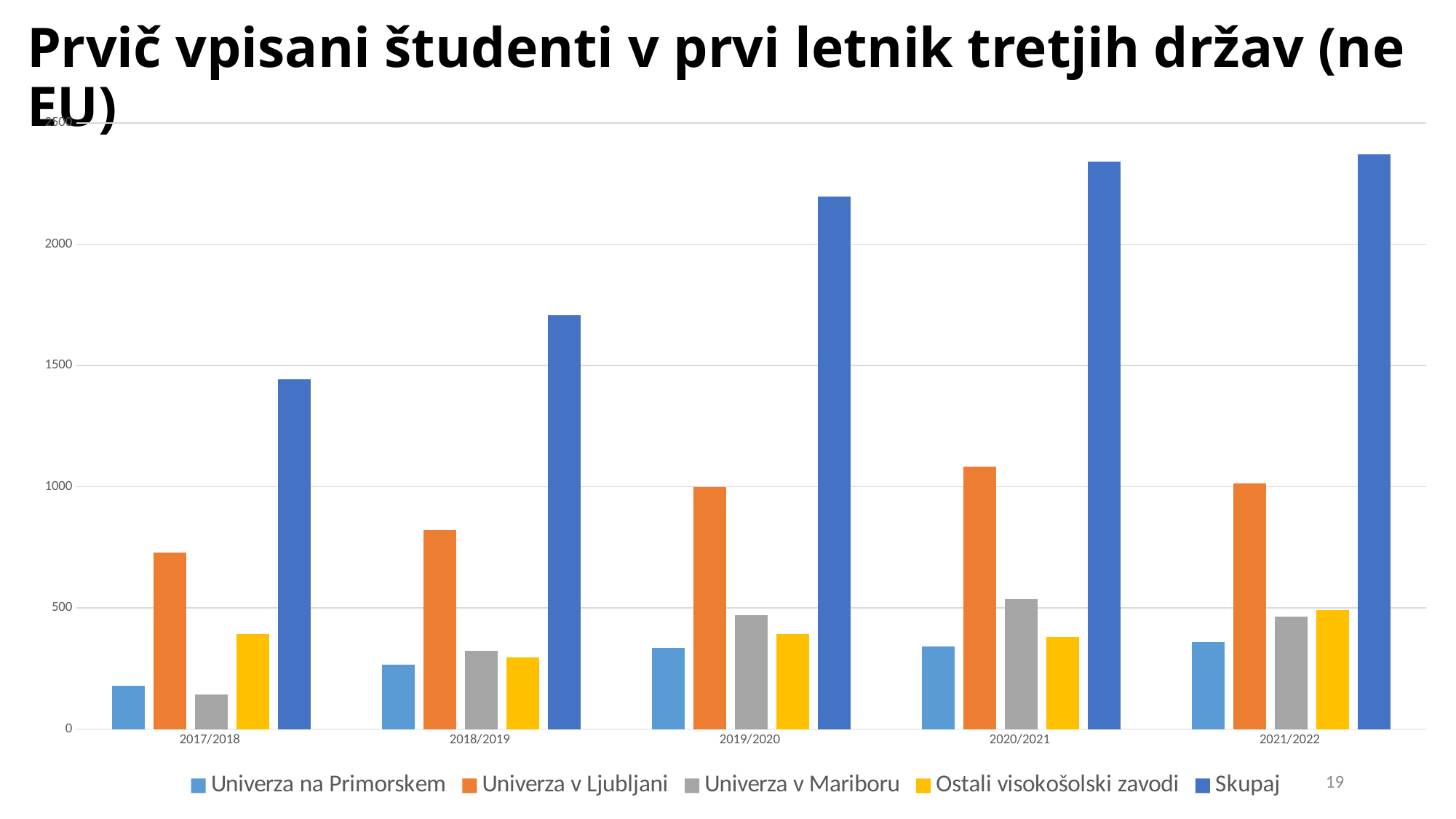
Is the value for Univerza v Ljubljani in 2020/2021 greater or less than 1000? greater How many academic years are shown on the x axis? 5 How many series does the legend list? 5 Is the value for Skupaj in 2019/2020 greater or less than 2000? greater In 2019/2020, which is larger: Univerza v Ljubljani or Univerza v Mariboru? Univerza v Ljubljani Do the values for Skupaj rise or fall from 2017/2018 to 2021/2022? rise In which academic year is the value for Skupaj lowest? 2017/2018 What kind of chart is shown on the slide? bar chart Is the value for Skupaj in 2017/2018 greater or less than 1500? less Which series has the lowest value in 2017/2018? Univerza v Mariboru What colour are the bars for Skupaj? dark blue